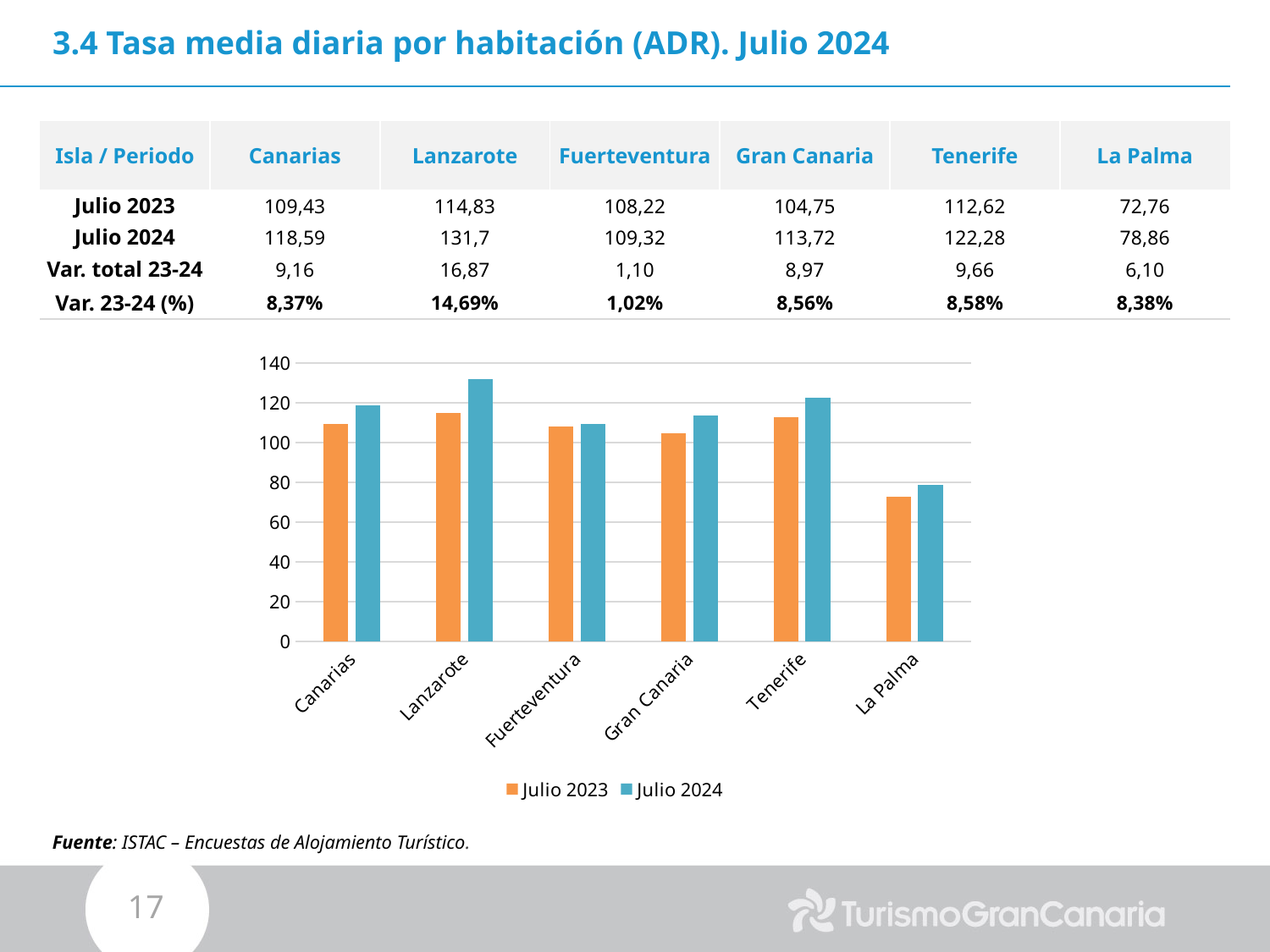
Which colour represents the Julio 2023 series in the chart? orange What is the Julio 2023 value for Tenerife? 112,62 Which category has the lowest Julio 2023 value in the chart? La Palma Which category has the highest Julio 2024 value in the chart? Lanzarote What is the difference between the Julio 2024 and Julio 2023 values for Gran Canaria? 8,97 What kind of chart is shown on the slide? bar chart Is the Julio 2024 value for La Palma greater or less than 80? less Is the Julio 2024 value for Lanzarote greater or less than 120? greater How many islands/categories are shown on the x axis of the chart? 6 How many series does the chart legend list? 2 Which is larger, the Julio 2024 value for Tenerife or the Julio 2024 value for Gran Canaria? Tenerife What is the Julio 2024 value for Lanzarote? 131,7